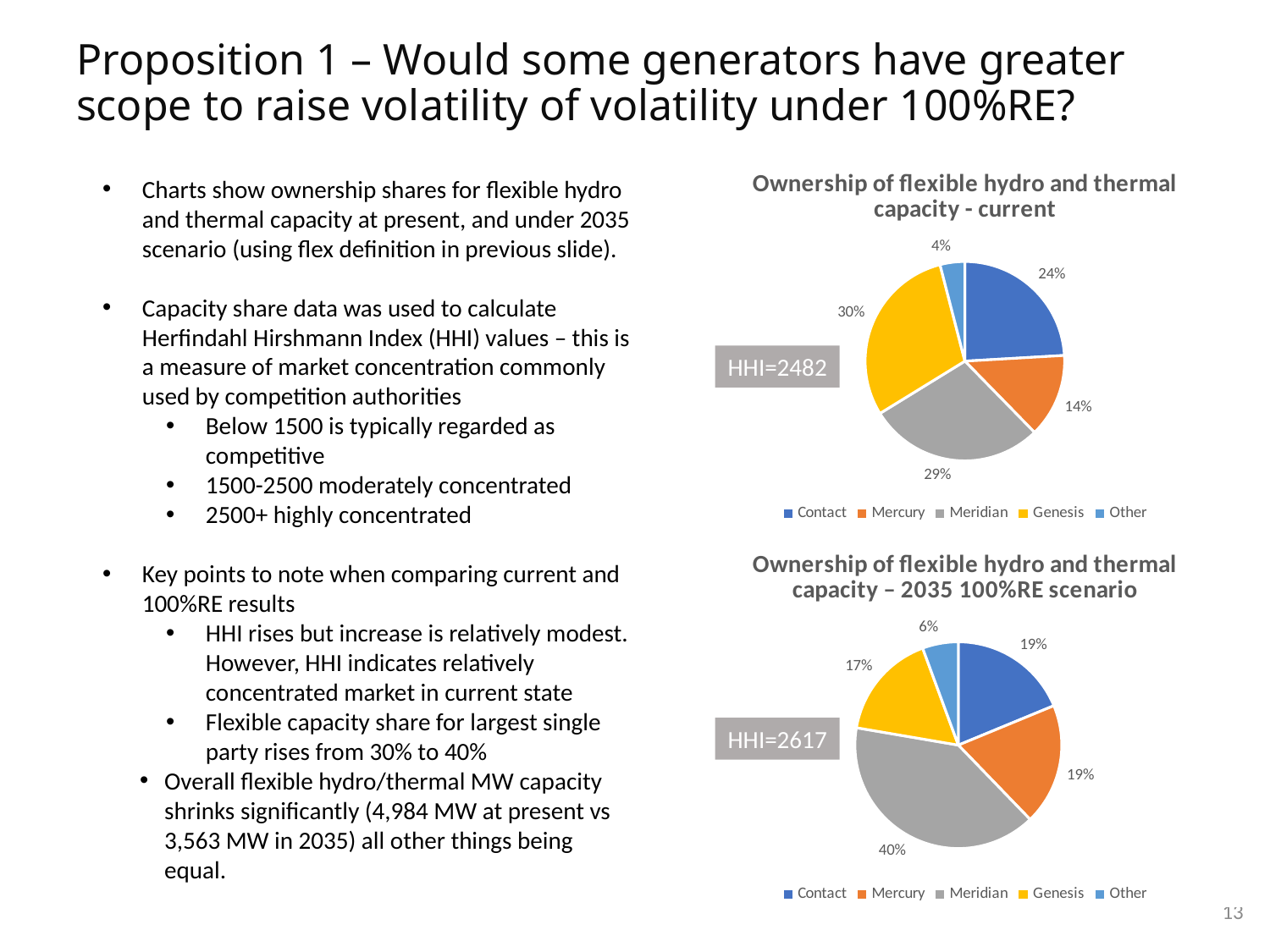
In the 'Ownership of flexible hydro and thermal capacity – 2035 100%RE scenario' chart, what share does Genesis hold? 17% In the 'Ownership of flexible hydro and thermal capacity - current' chart, what is the difference between the Genesis share and the Mercury share? 16% In the 'Ownership of flexible hydro and thermal capacity – 2035 100%RE scenario' chart, what is the difference between the Meridian share and the Contact share? 21% In the 'Ownership of flexible hydro and thermal capacity – 2035 100%RE scenario' chart, what share does Meridian hold? 40% In the 'Ownership of flexible hydro and thermal capacity - current' chart, how many slices does the pie have? 5 What type of chart is used for the 'Ownership of flexible hydro and thermal capacity - current' chart? Pie chart In the 'Ownership of flexible hydro and thermal capacity - current' chart, what share does Contact hold? 24% In the 'Ownership of flexible hydro and thermal capacity - current' chart, which owner has the smallest share? Other In the 'Ownership of flexible hydro and thermal capacity – 2035 100%RE scenario' chart, which is larger, the Genesis share or the Other share? Genesis In the 'Ownership of flexible hydro and thermal capacity - current' chart, what share does Mercury hold? 14% In the 'Ownership of flexible hydro and thermal capacity – 2035 100%RE scenario' chart, which owner has the largest share? Meridian How many entries does the legend of the 'Ownership of flexible hydro and thermal capacity – 2035 100%RE scenario' chart list? 5